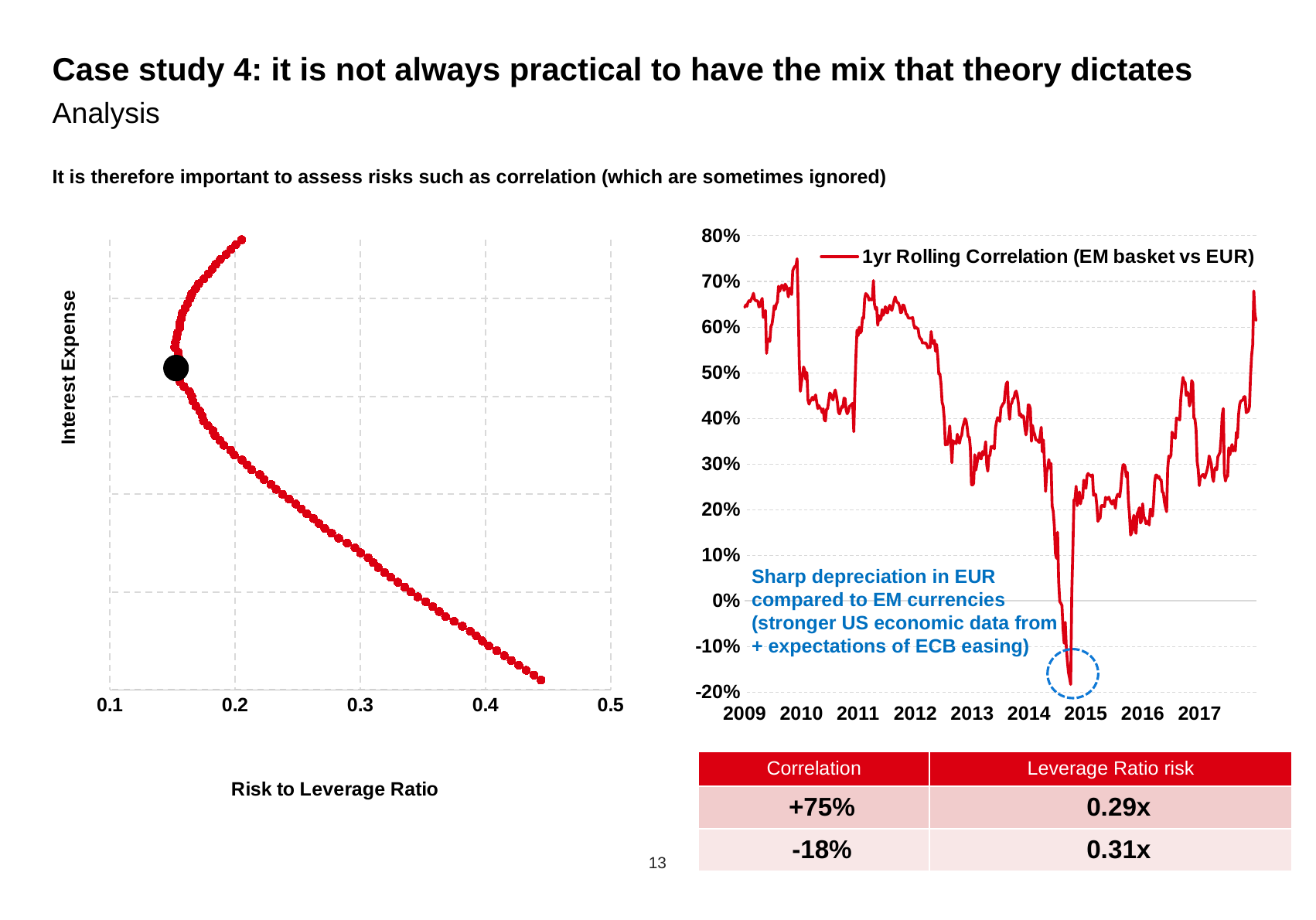
In the right chart, what is the legend entry for the plotted series? 1yr Rolling Correlation (EM basket vs EUR) In the right chart, is the 1yr Rolling Correlation higher at the start of 2009 or at the start of 2016? start of 2009 In the left chart, is the Risk to Leverage Ratio of the large black highlighted point greater or less than 0.2? less In the right chart, is the lowest value of the 1yr Rolling Correlation greater or less than 0%? less In the right chart, is the 1yr Rolling Correlation at the start of 2009 greater or less than 60%? greater In the right chart, in which year does the 1yr Rolling Correlation reach its lowest point? 2015 In the right chart, how many series does the legend list? 1 In the left chart, what is the label of the x axis? Risk to Leverage Ratio In the right chart, how many year labels are shown on the x axis? 9 What kind of chart is the left chart with the axis 'Risk to Leverage Ratio'? scatter chart What kind of chart is the right chart showing the 1yr Rolling Correlation? line chart